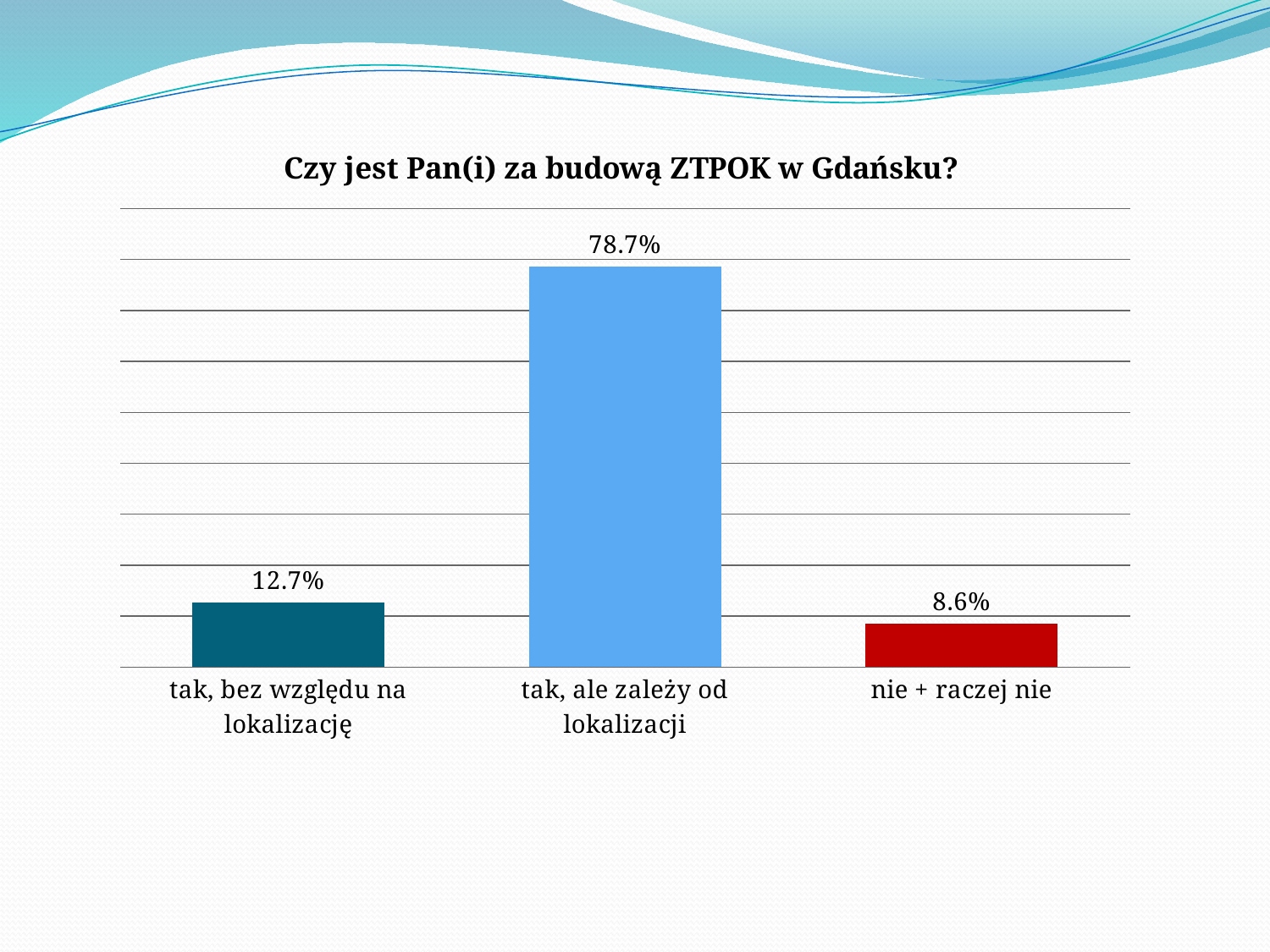
What is the value for "nie + raczej nie"? 8.6% How many categories are shown in the chart? 3 What is the difference between the values for "tak, ale zależy od lokalizacji" and "tak, bez względu na lokalizację"? 66.0% What colour is the bar for "nie + raczej nie"? red What kind of chart is shown on the slide? bar chart What is the difference between the values for "tak, bez względu na lokalizację" and "nie + raczej nie"? 4.1% What is the value for "tak, ale zależy od lokalizacji"? 78.7% Which is larger: the value for "tak, bez względu na lokalizację" or the value for "nie + raczej nie"? tak, bez względu na lokalizację Which category has the highest value? tak, ale zależy od lokalizacji What is the value for "tak, bez względu na lokalizację"? 12.7% What is the title of the chart? Czy jest Pan(i) za budową ZTPOK w Gdańsku? Which category has the lowest value? nie + raczej nie